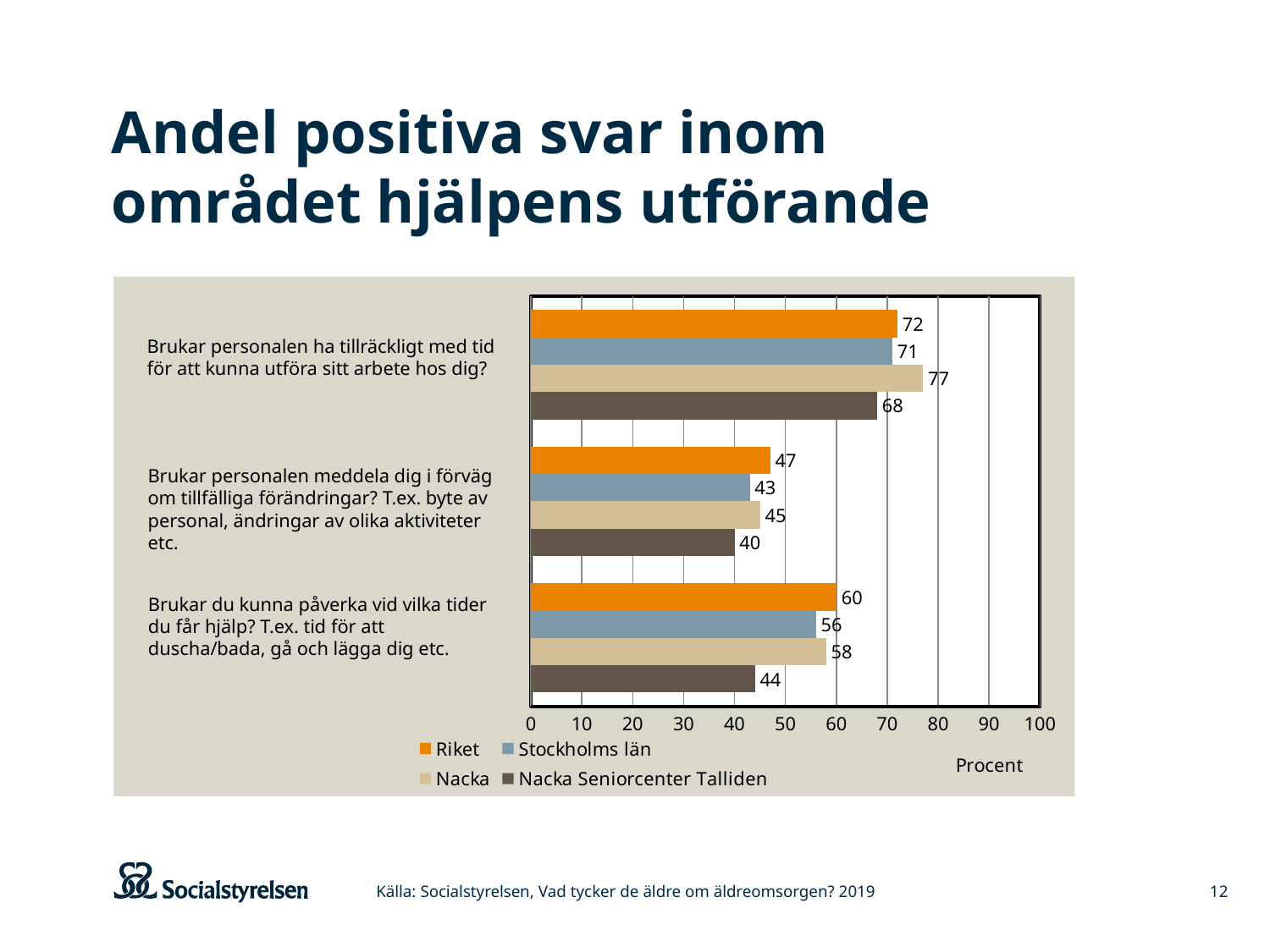
Which is larger on the question "Brukar personalen meddela dig i förväg om tillfälliga förändringar?": Riket or Nacka? Riket Is the value for Nacka Seniorcenter Talliden on the question "Brukar personalen ha tillräckligt med tid för att kunna utföra sitt arbete hos dig?" greater or less than 60? greater What is the value for Nacka on the question "Brukar personalen ha tillräckligt med tid för att kunna utföra sitt arbete hos dig?" 77 What is the label on the horizontal axis of the chart? Procent Which series has the highest value on the question "Brukar personalen ha tillräckligt med tid för att kunna utföra sitt arbete hos dig?" Nacka How many questions (categories) are shown on the chart? 3 What is the difference between Riket and Nacka Seniorcenter Talliden on the question "Brukar du kunna påverka vid vilka tider du får hjälp?" 16 What is the value for Nacka Seniorcenter Talliden on the question "Brukar du kunna påverka vid vilka tider du får hjälp?" 44 What kind of chart is shown on the slide? Bar chart How many series does the legend list? 4 What is the value for Stockholms län on the question "Brukar personalen meddela dig i förväg om tillfälliga förändringar?" 43 Which series has the lowest value on the question "Brukar du kunna påverka vid vilka tider du får hjälp?" Nacka Seniorcenter Talliden